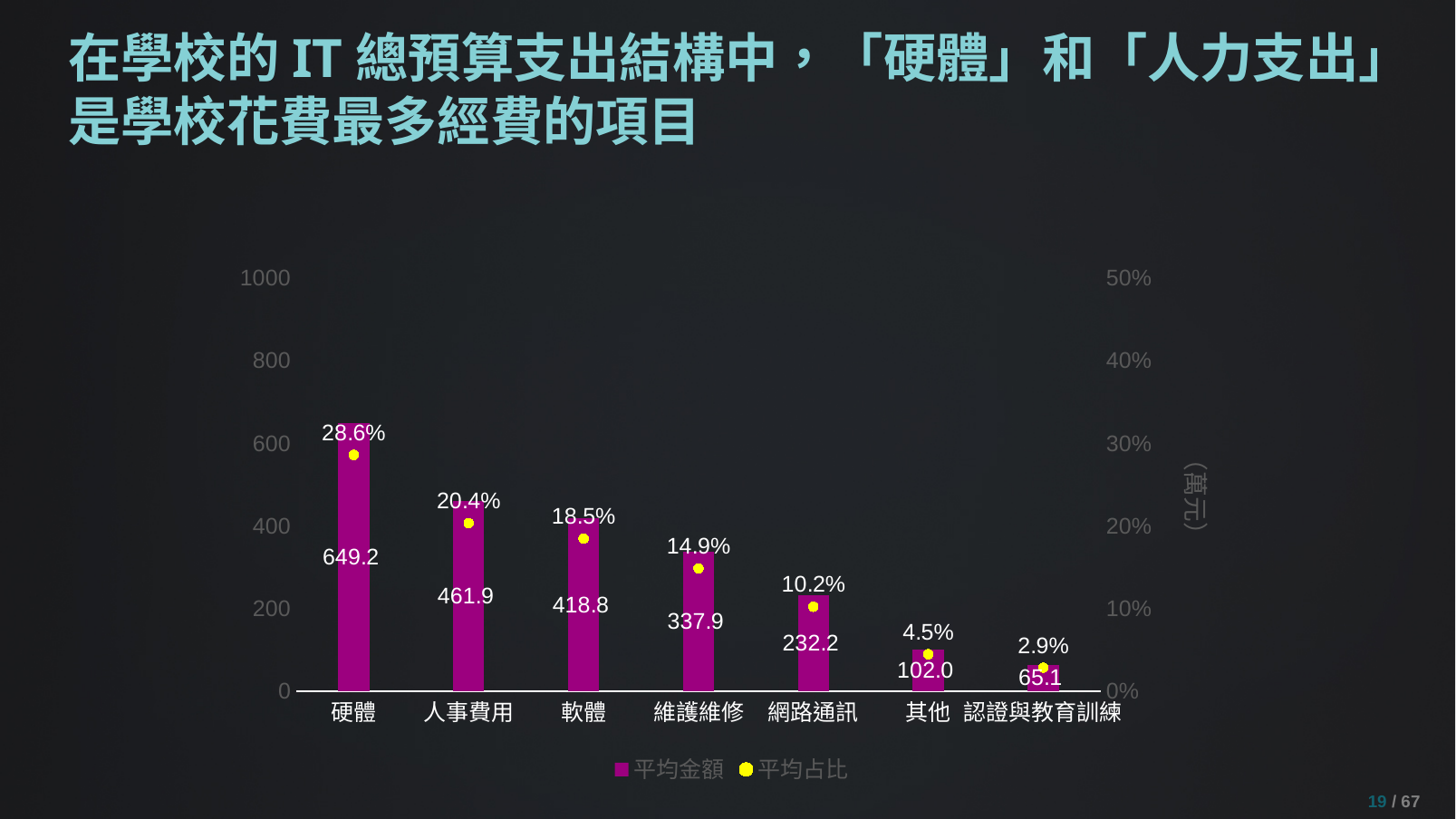
How many categories are shown on the x axis? 7 What is the 平均金額 value for 網路通訊? 232.2 How many series does the legend list? 2 Which category has the lowest 平均占比? 認證與教育訓練 What is the 平均占比 value for 人事費用? 20.4% Which has a larger 平均金額, 軟體 or 維護維修? 軟體 Do the 平均金額 values rise or fall from left to right along the x axis? fall Which category has the highest 平均金額? 硬體 What colour are the 平均占比 markers? yellow What is the 平均占比 value for 認證與教育訓練? 2.9% What is the difference in 平均金額 between 硬體 and 人事費用? 187.3 What is the 平均金額 value for 硬體? 649.2